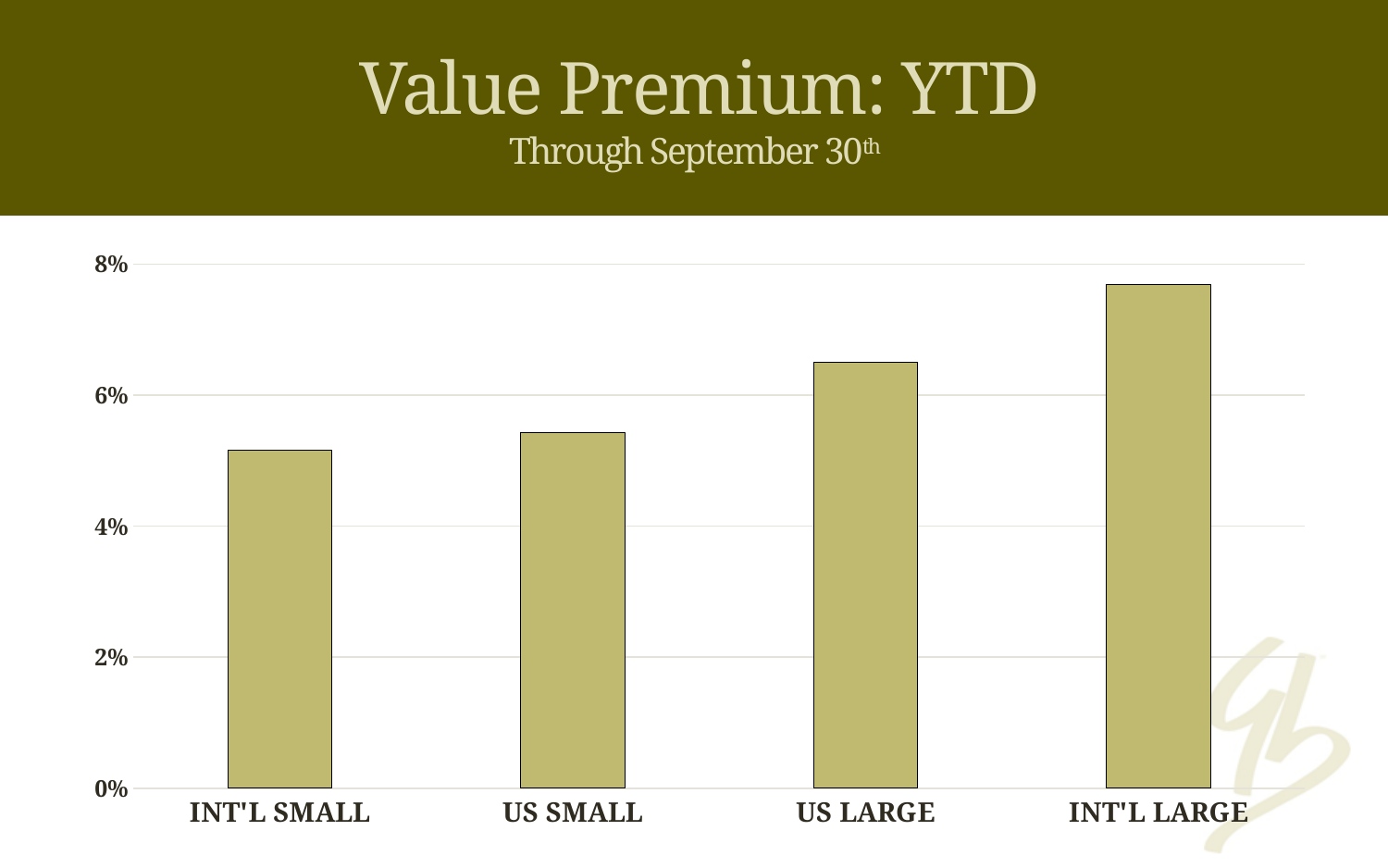
What is the title of the slide? Value Premium: YTD Is the value for US LARGE greater or less than 6%? greater What period does the subtitle say the chart covers? Through September 30th Which category has the highest value premium? INT'L LARGE What kind of chart is shown on the slide? Bar chart Is the value for INT'L SMALL greater or less than 4%? greater Which is larger, the value for INT'L LARGE or the value for INT'L SMALL? INT'L LARGE Do the bar values rise or fall from left to right across the categories? Rise Is the value for US SMALL greater or less than 6%? less How many categories are plotted on the chart? 4 Which is larger, the value for US LARGE or the value for US SMALL? US LARGE